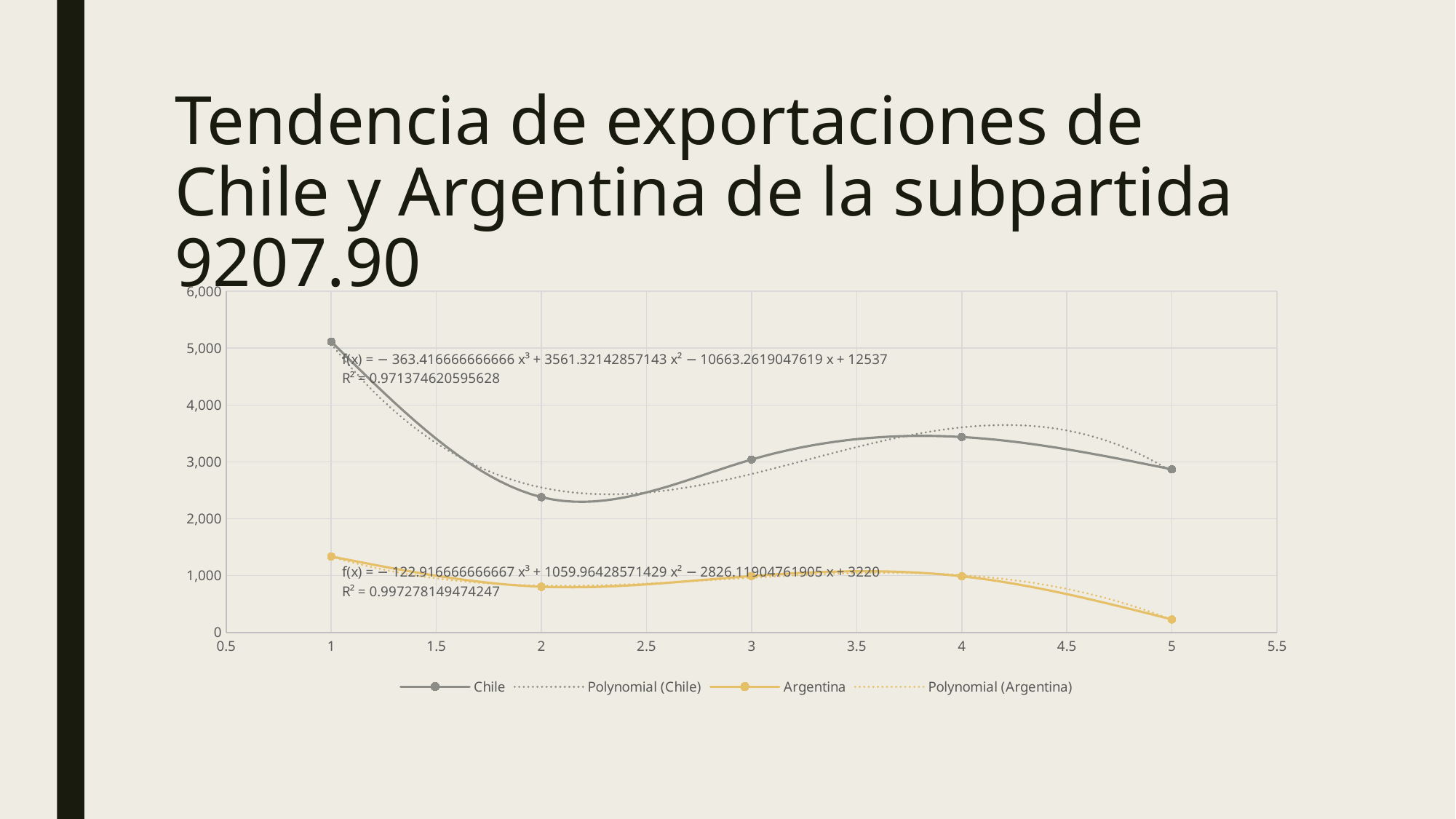
At which x value is the Chile series highest? 1 What kind of chart is shown on the slide? Line chart Which series has the larger value at x = 3, Chile or Argentina? Chile What R² value is shown for the Argentina polynomial trendline? 0.997278149474247 Does the Chile series rise or fall between x = 1 and x = 2? Fall Is the value for Argentina at x = 5 greater or less than 1,000? less Is the value for Chile at x = 1 greater or less than 5,000? greater How many data points are plotted for the Chile series? 5 How many series does the legend list? 4 At which x value is the Chile series lowest? 2 Is the value for Chile at x = 4 greater or less than 3,000? greater At which x value is the Argentina series lowest? 5